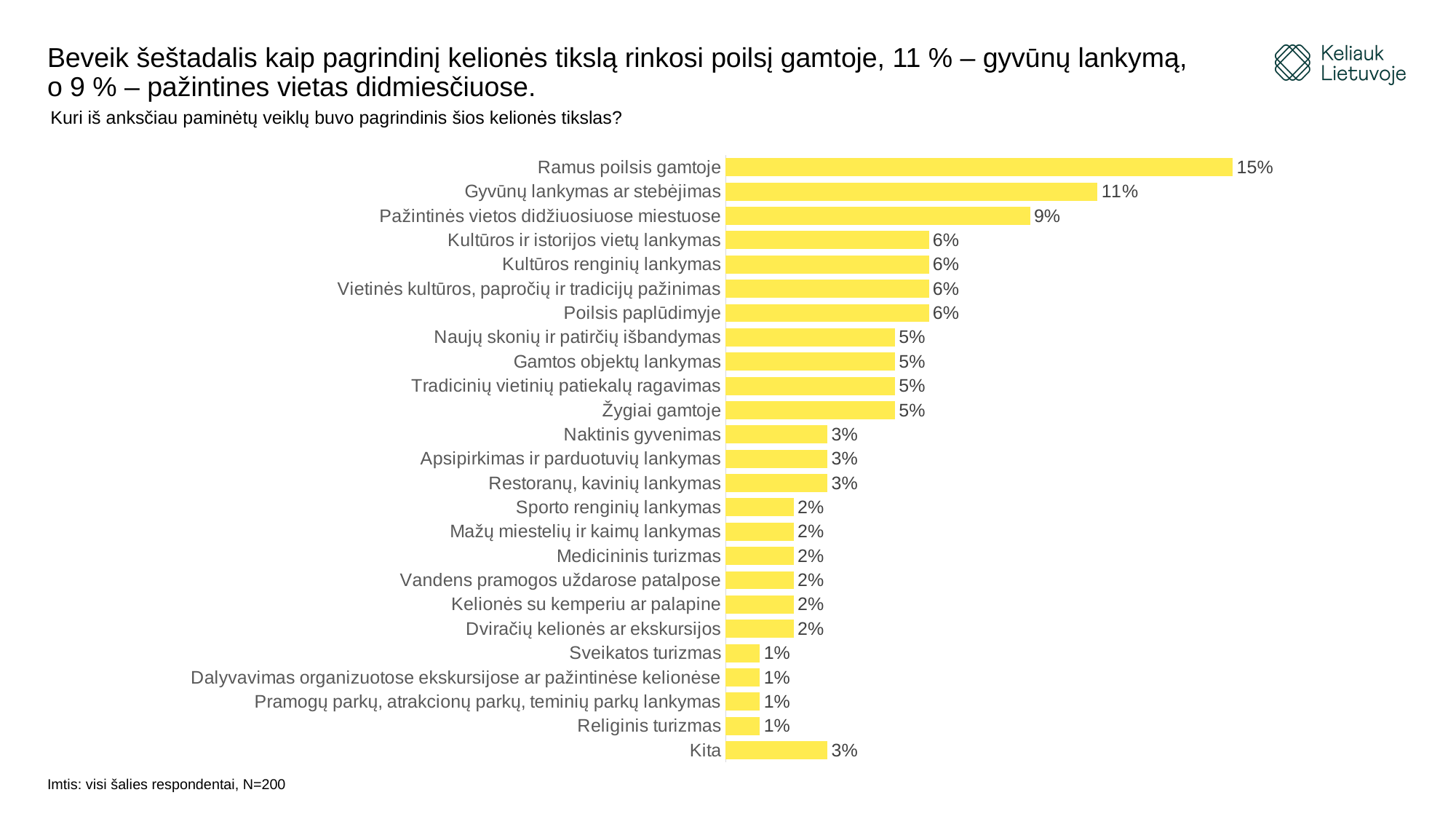
What is the value for Naktinis gyvenimas? 3% Which is larger, the value for Žygiai gamtoje or the value for Sporto renginių lankymas? Žygiai gamtoje What is the value for Pažintinės vietos didžiuosiuose miestuose? 9% Which category has the highest value? Ramus poilsis gamtoje What kind of chart is shown on the slide? Bar chart What is the value for Ramus poilsis gamtoje? 15% What is the value for Gyvūnų lankymas ar stebėjimas? 11% What is the difference between the values for Ramus poilsis gamtoje and Gyvūnų lankymas ar stebėjimas? 4% What is the value for Religinis turizmas? 1% How many categories are shown in the chart? 25 What colour are the bars in the chart? Yellow What is the difference between the values for Pažintinės vietos didžiuosiuose miestuose and Poilsis paplūdimyje? 3%